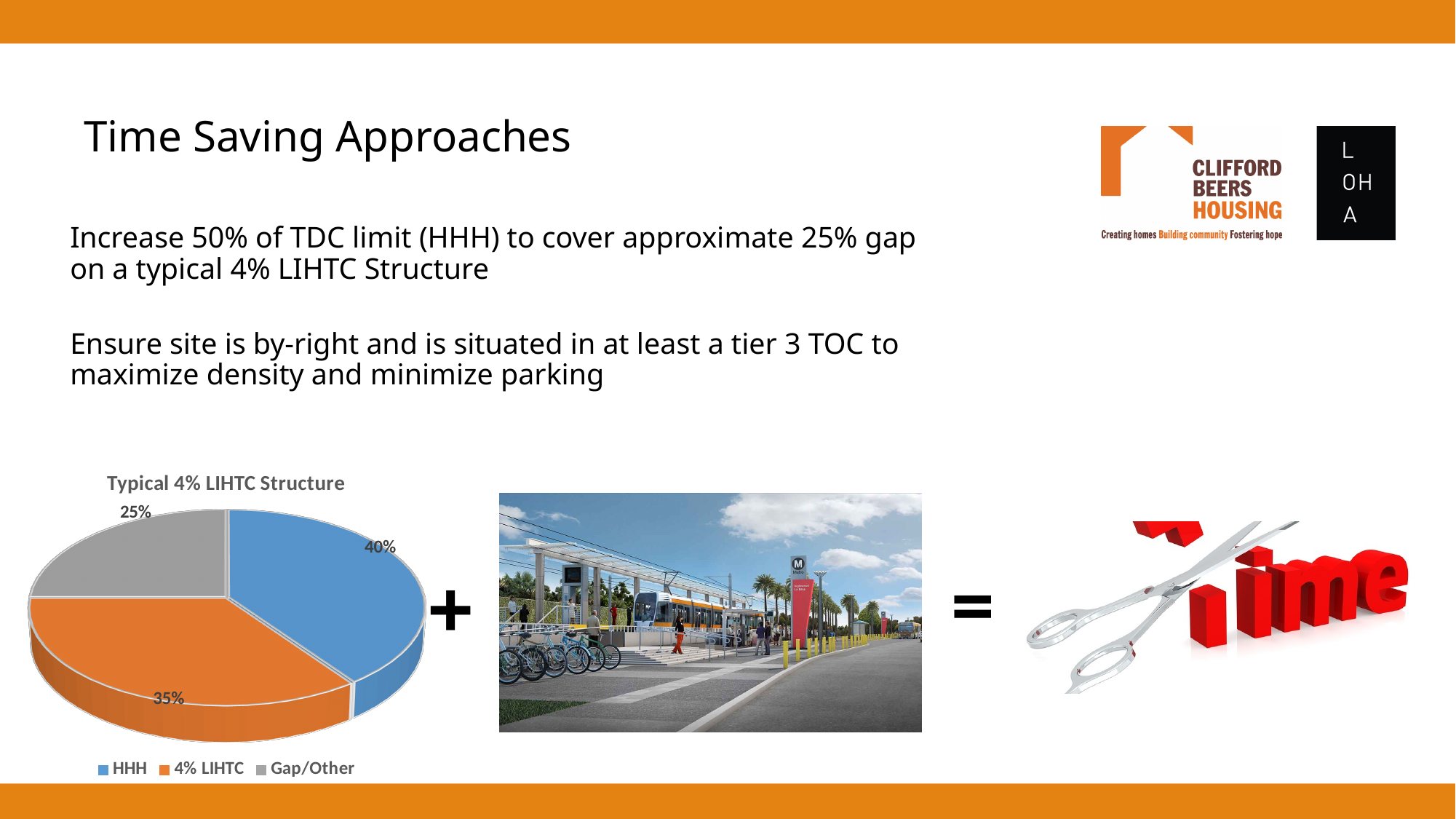
Which category has the smallest slice of the pie? Gap/Other What share of the pie does Gap/Other represent? 25% What type of chart is shown on the slide? pie chart How many slices does the pie chart have? 3 Which category has the largest slice of the pie? HHH How many entries does the legend list? 3 What share of the pie does 4% LIHTC represent? 35% What colour is the 4% LIHTC slice? orange Which is larger, the HHH slice or the 4% LIHTC slice? HHH What is the title of the chart? Typical 4% LIHTC Structure What is the difference between the HHH share and the Gap/Other share? 15% What share of the pie does HHH represent? 40%